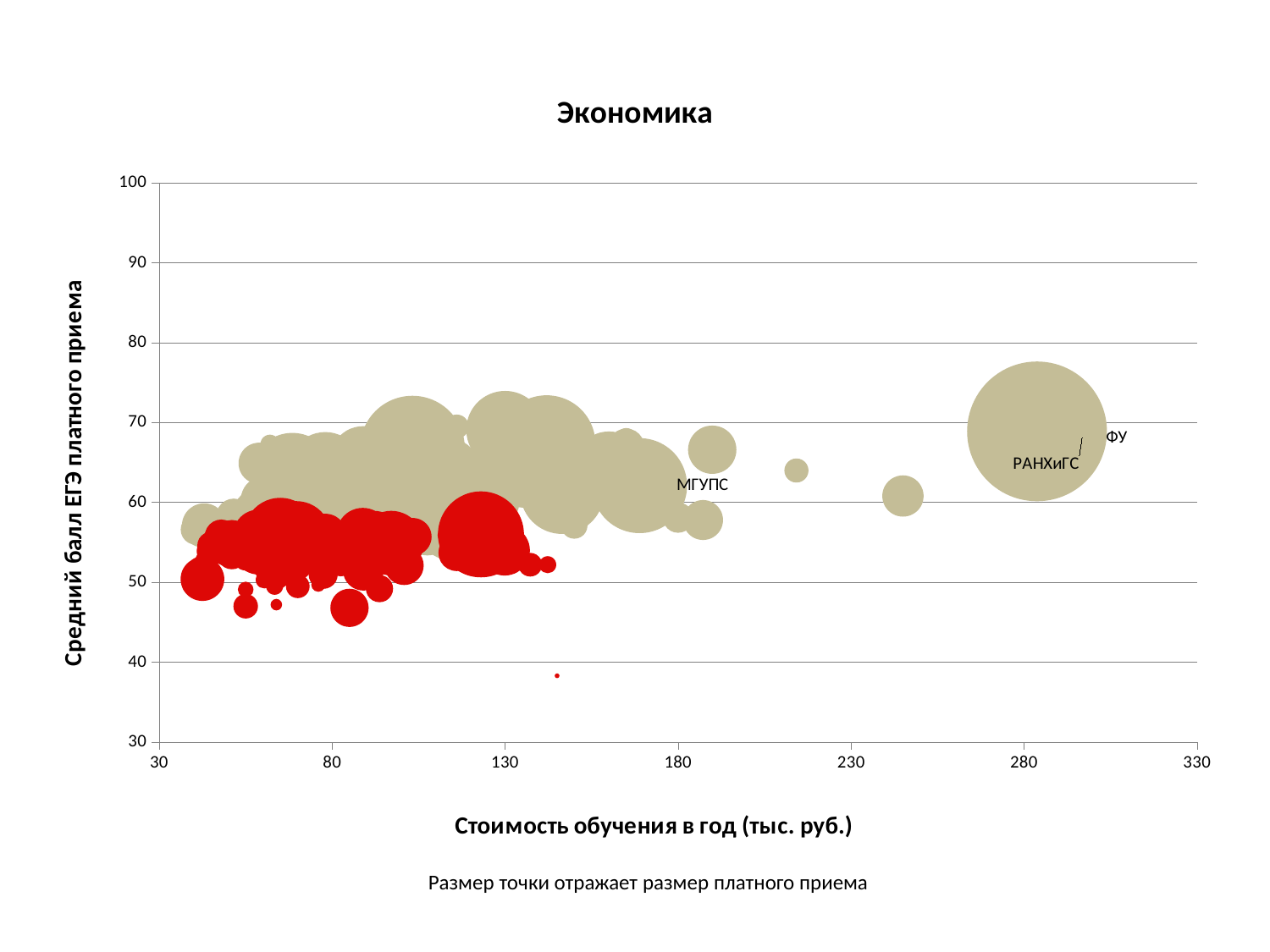
Are all the red bubbles located at tuition costs less than 180 thousand rubles? yes What is the highest value shown on the vertical axis? 100 What is the title of the chart? Экономика Is the average ЕГЭ score for the lowest red bubble greater or less than 40? less Which labeled institution has the highest tuition cost on the chart? ФУ What is the label of the horizontal axis of the chart? Стоимость обучения в год (тыс. руб.) Is the average ЕГЭ score for ФУ greater or less than 80? less Which group of bubbles generally has lower average ЕГЭ scores: the red bubbles or the beige bubbles? red What kind of chart is shown on the slide? bubble chart